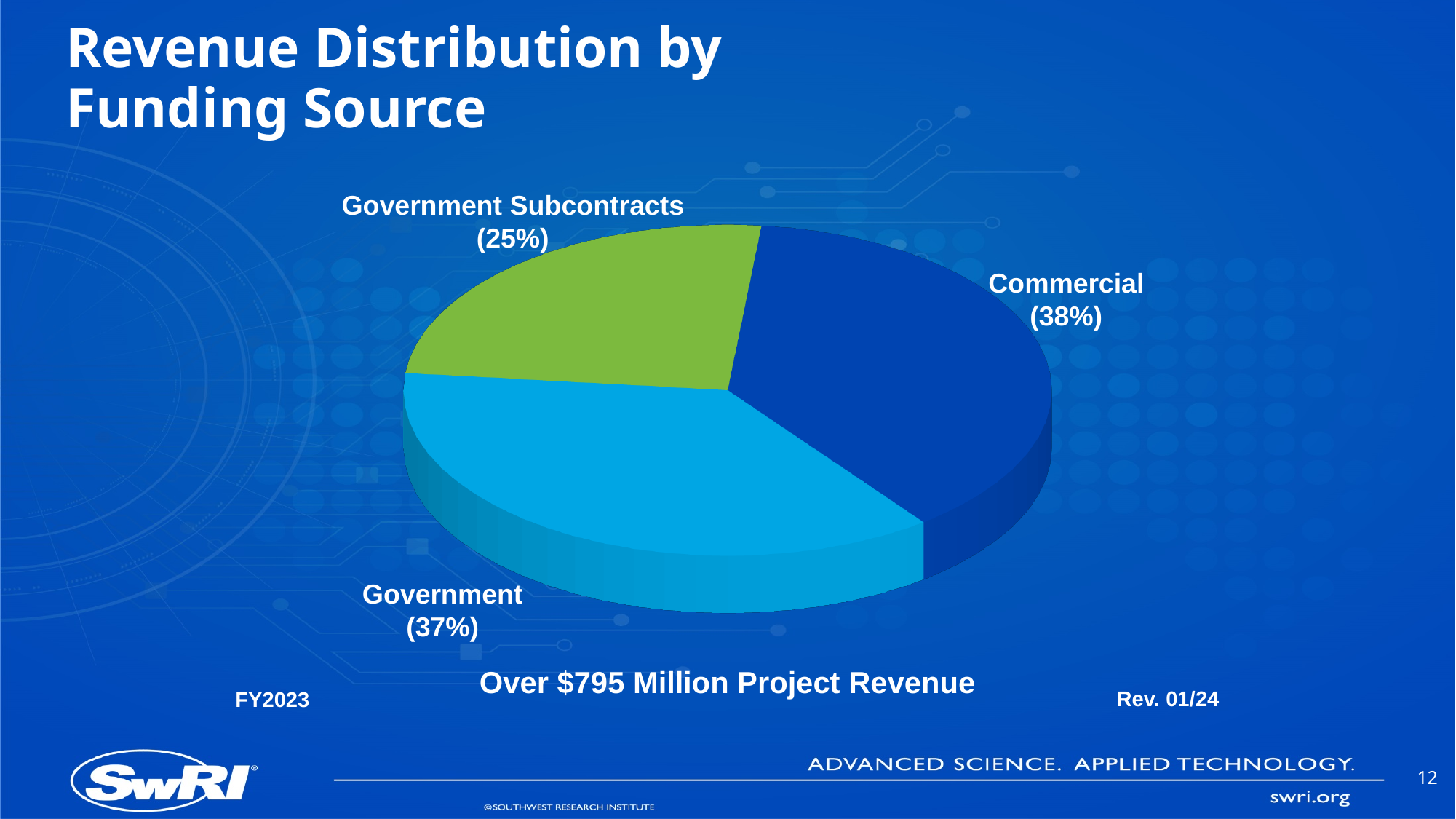
What is the difference in percentage points between the Government and Government Subcontracts shares? 12 What share of revenue comes from Commercial funding? 38% Is the Government Subcontracts share greater or less than 30%? less What is the difference in percentage points between the Commercial and Government Subcontracts shares? 13 What total project revenue is stated below the pie chart? Over $795 Million How many funding sources are shown in the pie chart? 3 Which funding source has the largest share of revenue? Commercial What kind of chart is shown on the slide? Pie chart Which funding source has the smallest share of revenue? Government Subcontracts What is the title of the chart on the slide? Revenue Distribution by Funding Source What share of revenue comes from Government Subcontracts? 25% What share of revenue comes from Government funding? 37%